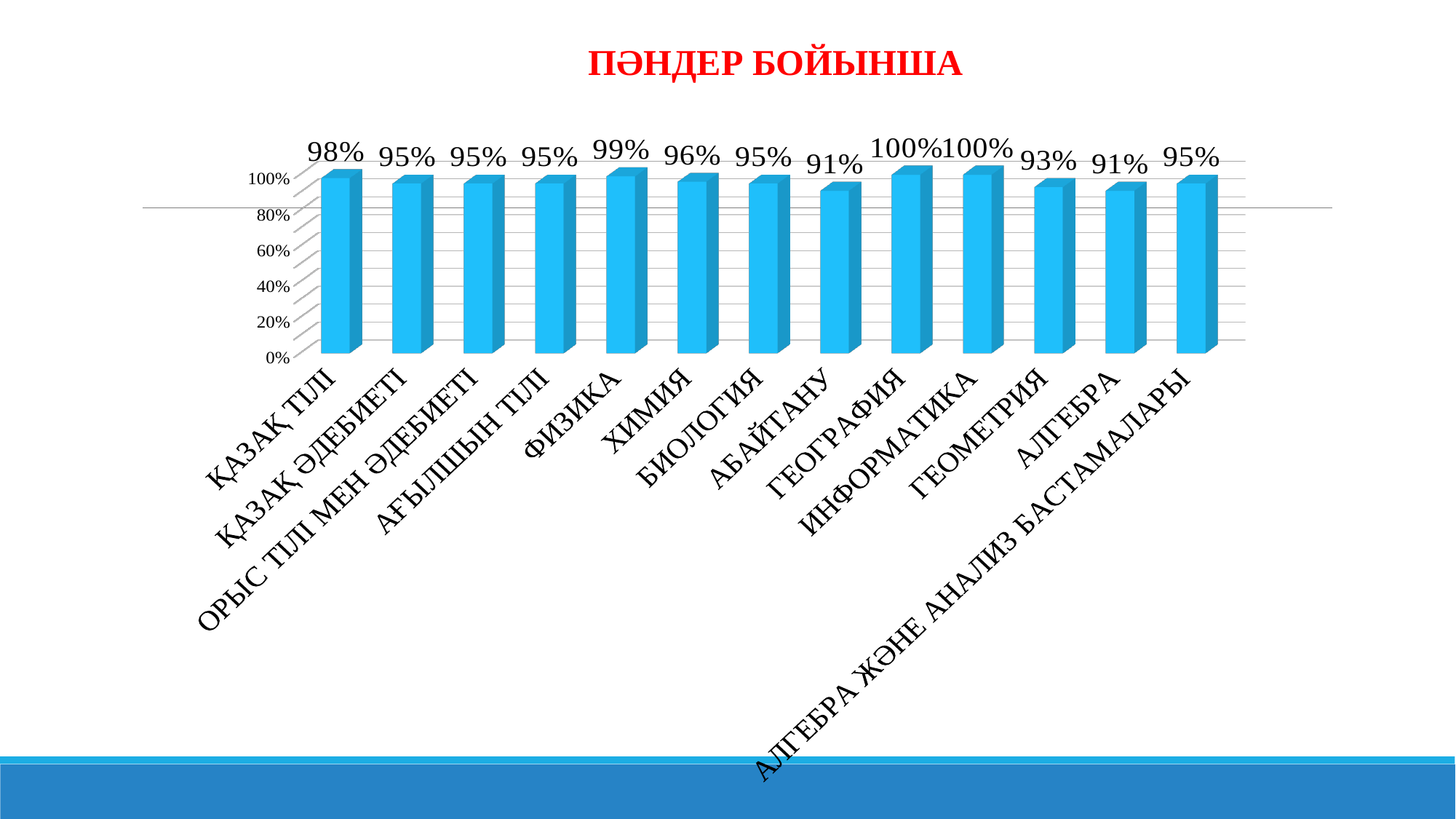
What is the value for ҚАЗАҚ ТІЛІ? 98% What is the title of the slide? ПӘНДЕР БОЙЫНША What is the difference between the values for ГЕОГРАФИЯ and АЛГЕБРА? 9% How many categories are shown on the chart? 13 What is the value for ГЕОМЕТРИЯ? 93% What kind of chart is shown on the slide? Bar chart What is the value for ФИЗИКА? 99% Which is larger, the value for ФИЗИКА or the value for ХИМИЯ? ФИЗИКА What is the value for ХИМИЯ? 96% What is the value for АБАЙТАНУ? 91% Which two categories share the lowest value on the chart? АБАЙТАНУ and АЛГЕБРА Which two categories share the highest value on the chart? ГЕОГРАФИЯ and ИНФОРМАТИКА